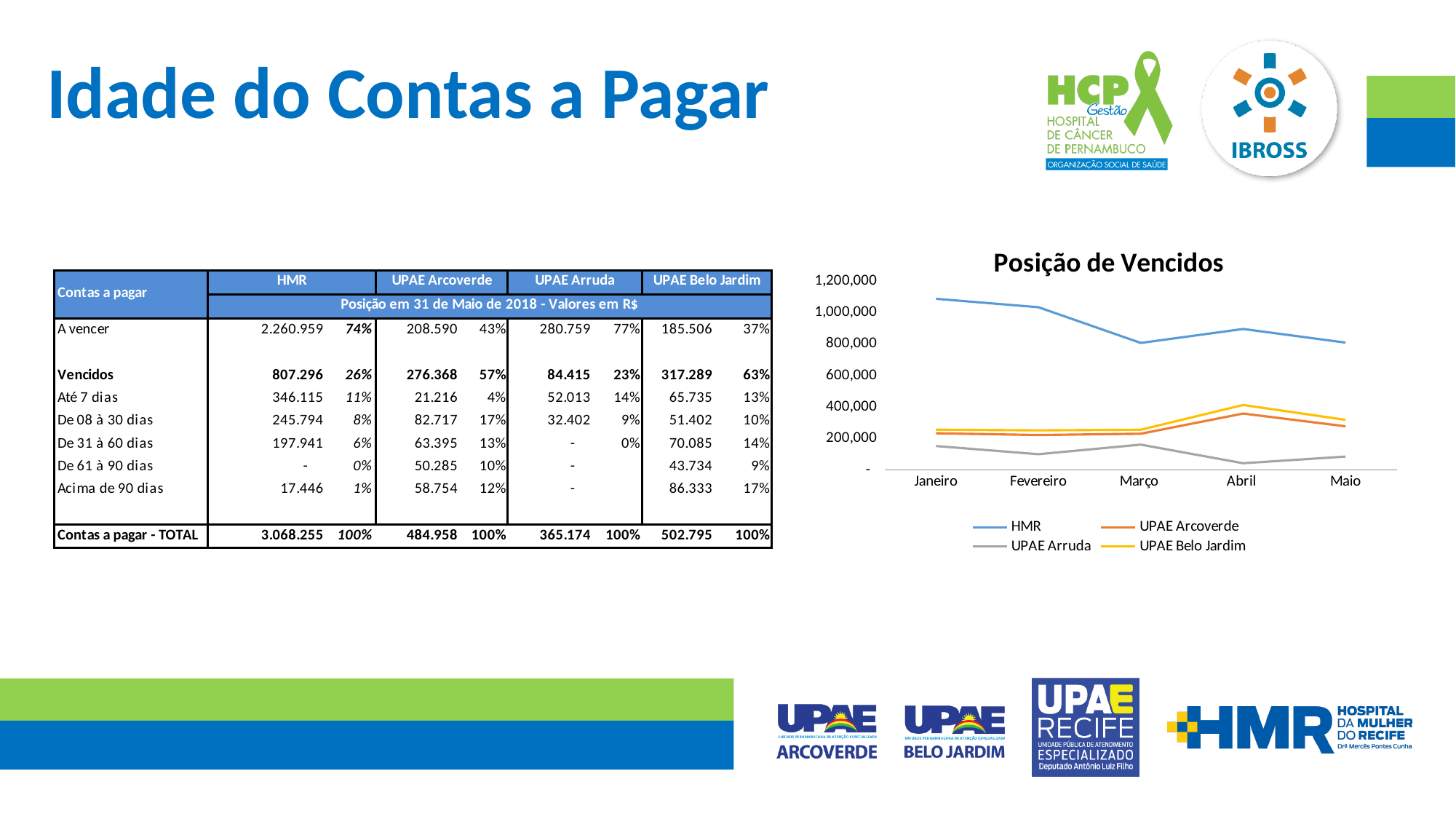
What kind of chart is "Posição de Vencidos"? line chart In the "Posição de Vencidos" chart, which series has the lowest value in Abril? UPAE Arruda In the "Posição de Vencidos" chart, is the UPAE Belo Jardim value for Abril greater or less than 200,000? greater In the "Posição de Vencidos" chart, is the HMR value for Abril greater or less than 1,000,000? less In the "Posição de Vencidos" chart, is the UPAE Arruda value for Abril greater or less than 200,000? less How many months are shown on the x axis of the "Posição de Vencidos" chart? 5 In the "Posição de Vencidos" chart, which series is drawn in grey? UPAE Arruda In the "Posição de Vencidos" chart, in which month is the HMR value highest? Janeiro In the "Posição de Vencidos" chart, does the HMR line rise or fall from Janeiro to Março? fall In the "Posição de Vencidos" chart, which series has the highest values across all months? HMR How many series does the legend of the "Posição de Vencidos" chart list? 4